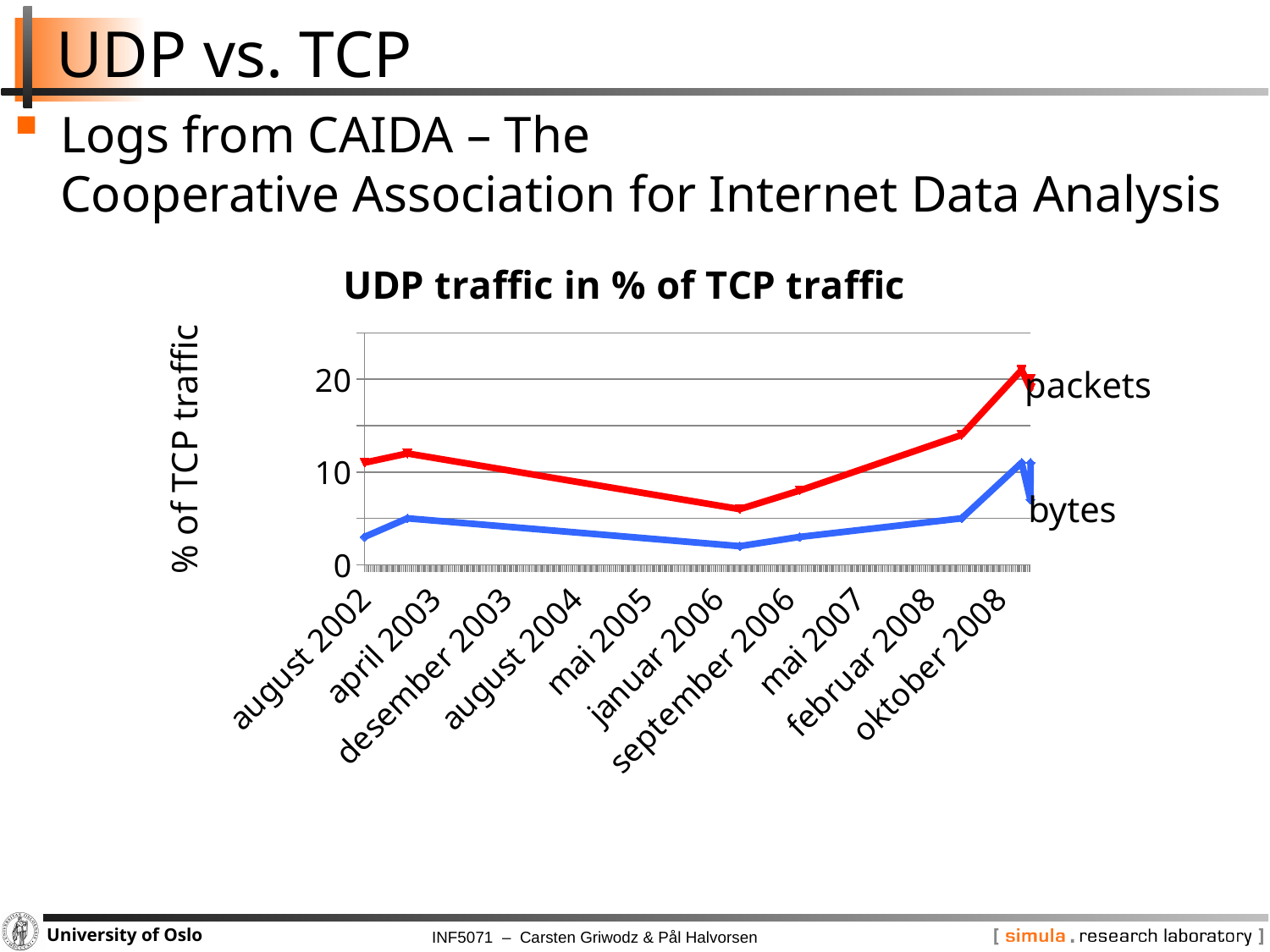
At which date does the packets series reach its lowest value? januar 2006 Which series has the higher value in mai 2007, packets or bytes? packets Is the value for packets in januar 2006 greater or less than 10? less At which date does the bytes series reach its lowest value? januar 2006 Which series is drawn in red? packets Is the value for bytes in februar 2008 greater or less than 10? less At which date does the packets series reach its highest value? oktober 2008 How many labelled dates are shown on the x axis? 10 What kind of chart is shown on the slide? line chart What is the title of the chart? UDP traffic in % of TCP traffic Is the value for packets in februar 2008 greater or less than 10? greater How many series does the chart show? 2